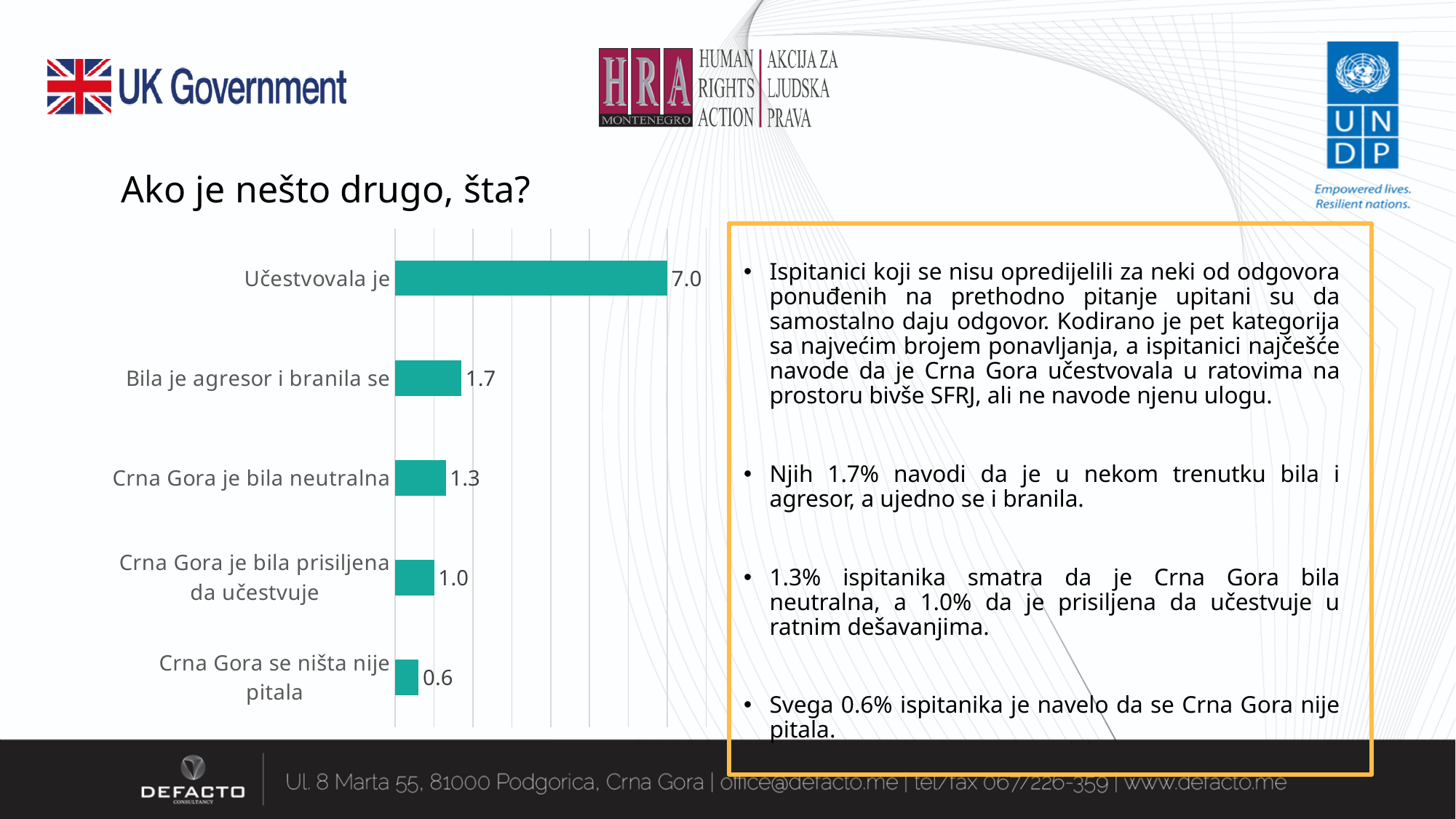
What is the value for "Učestvovala je"? 7.0 How many categories are shown in the chart? 5 What is the value for "Crna Gora je bila neutralna"? 1.3 Which is larger: the value for "Crna Gora je bila neutralna" or for "Crna Gora je bila prisiljena da učestvuje"? Crna Gora je bila neutralna What is the difference between the values for "Učestvovala je" and "Bila je agresor i branila se"? 5.3 What kind of chart is shown on the slide? Bar chart What is the value for "Crna Gora se ništa nije pitala"? 0.6 Which category has the lowest value? Crna Gora se ništa nije pitala What is the difference between the values for "Crna Gora je bila neutralna" and "Crna Gora se ništa nije pitala"? 0.7 Which category has the highest value? Učestvovala je What is the title of the slide above the chart? Ako je nešto drugo, šta? What is the value for "Bila je agresor i branila se"? 1.7